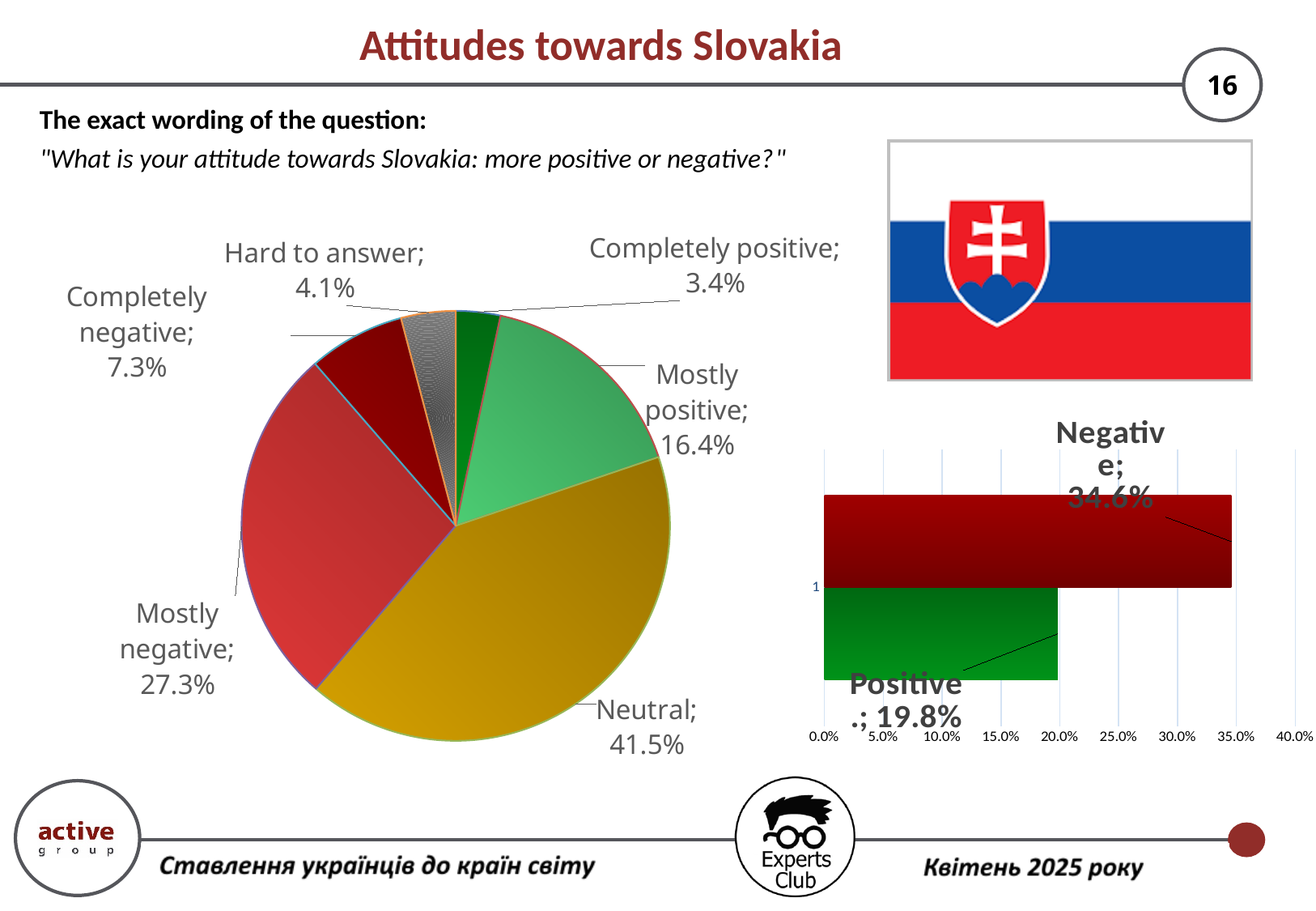
In the pie chart, what share of respondents answered Completely positive? 3.4% In the pie chart, which category has the smallest share? Completely positive In the pie chart, what share of respondents answered Neutral? 41.5% In the pie chart, which is larger: Completely negative or Hard to answer? Completely negative In the bar chart on the right, what is the value for Positive? 19.8% In the bar chart on the right, what is the difference between Negative and Positive? 14.8% How many categories does the pie chart show? 6 In the pie chart, what share of respondents answered Mostly negative? 27.3% In the pie chart, what is the difference between Mostly negative and Mostly positive? 10.9% What kind of chart is shown on the right side of the slide? Bar chart In the pie chart, which category has the largest share? Neutral In the bar chart on the right, what is the value for Negative? 34.6%